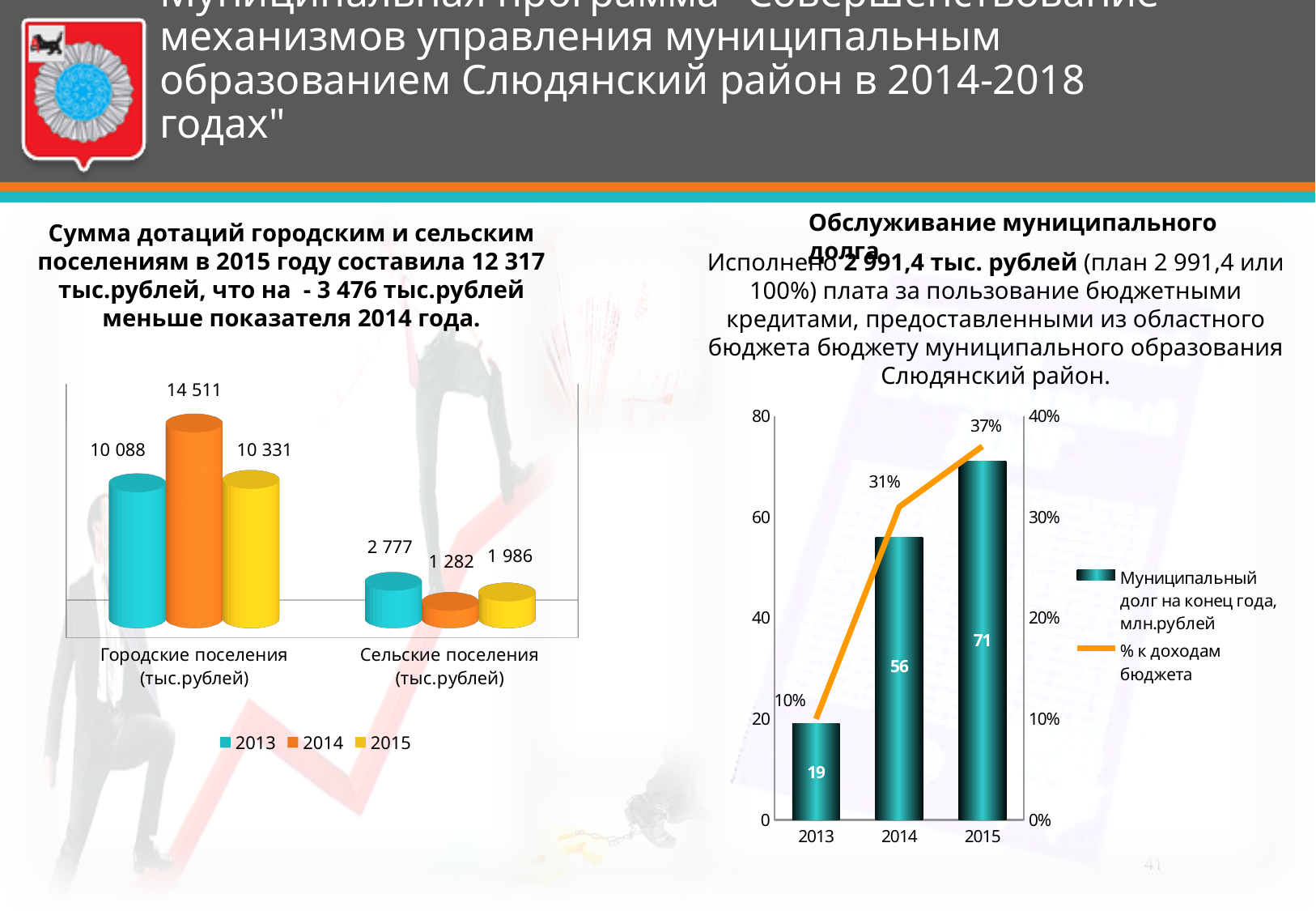
On the left chart, what is the value for Сельские поселения in 2015? 1 986 On the right chart, how many years are shown on the x axis? 3 On the left chart, what is the value for Городские поселения in 2014? 14 511 On the right chart, what is the difference in municipal debt between 2015 and 2013? 52 On the left chart, which year has the highest value for Городские поселения? 2014 On the right chart, does the municipal debt rise or fall from 2013 to 2015? Rises On the left chart, which year has the lowest value for Сельские поселения? 2014 On the right chart, what is the municipal debt at the end of 2014 (млн.рублей)? 56 On the right chart, what is the % к доходам бюджета value for 2015? 37% On the left chart, what is the difference between the 2014 and 2013 values for Городские поселения? 4 423 On the left chart, what kind of chart is shown? Bar chart On the left chart, how many series does the legend list? 3